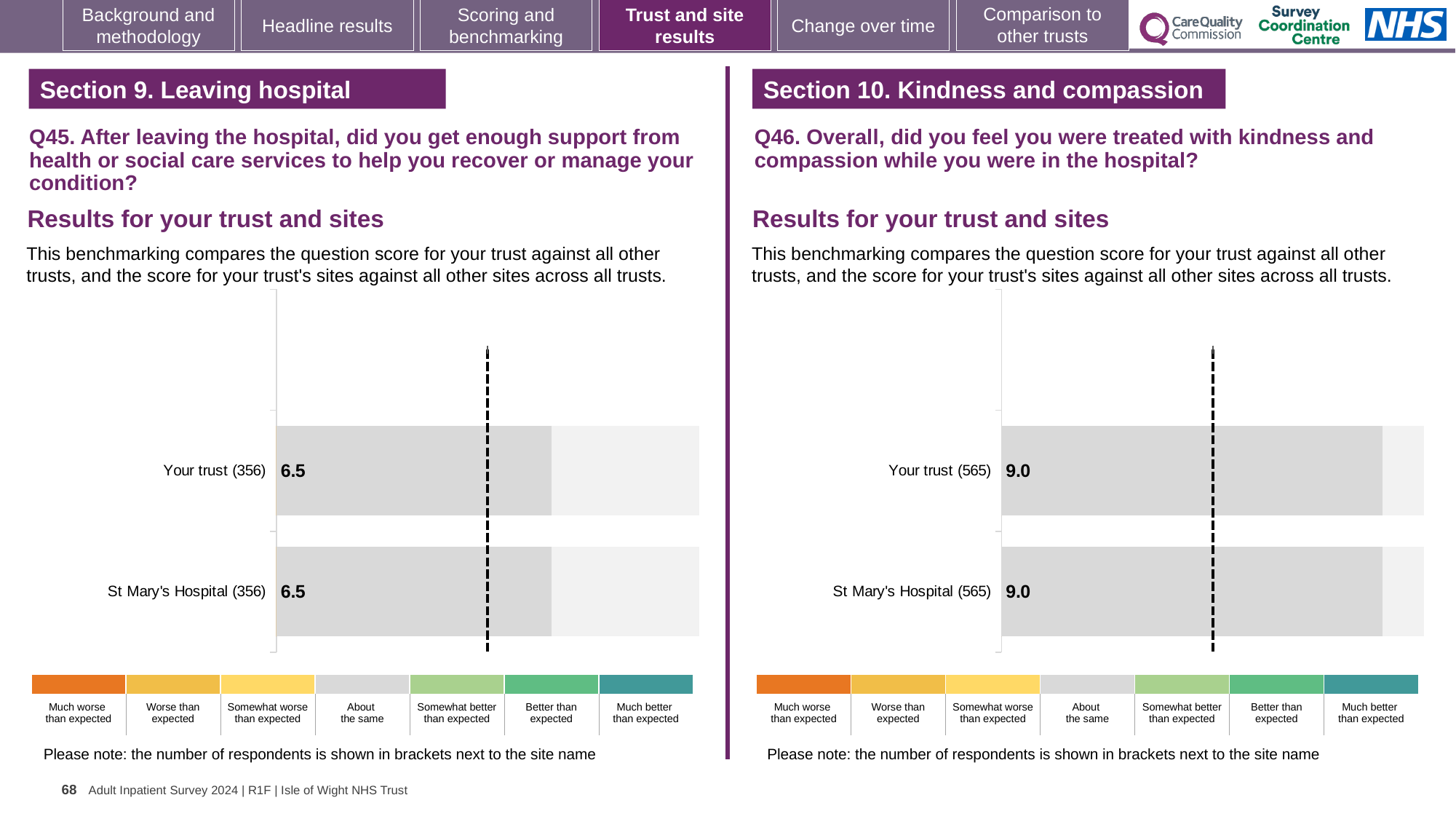
In the Q45 chart on the left, what is the score for St Mary's Hospital? 6.5 In the Q45 chart on the left, how many respondents are shown in brackets next to Your trust? 356 How many bars are plotted in the Q45 chart on the left? 2 In the Q46 chart on the right, what is the score for St Mary's Hospital? 9.0 What type of chart is used in the Q45 chart on the left? Bar chart Which is larger: the Your trust score in the Q46 chart on the right or the Your trust score in the Q45 chart on the left? Q46 chart (9.0) In the Q45 chart on the left, are the scores for Your trust and St Mary's Hospital the same or different? The same In the Q45 chart on the left, what is the score for Your trust? 6.5 What is the difference between the St Mary's Hospital score in the Q46 chart on the right and the St Mary's Hospital score in the Q45 chart on the left? 2.5 In the Q46 chart on the right, how many respondents are shown in brackets next to St Mary's Hospital? 565 How many bars are plotted in the Q46 chart on the right? 2 In the Q46 chart on the right, what is the score for Your trust? 9.0